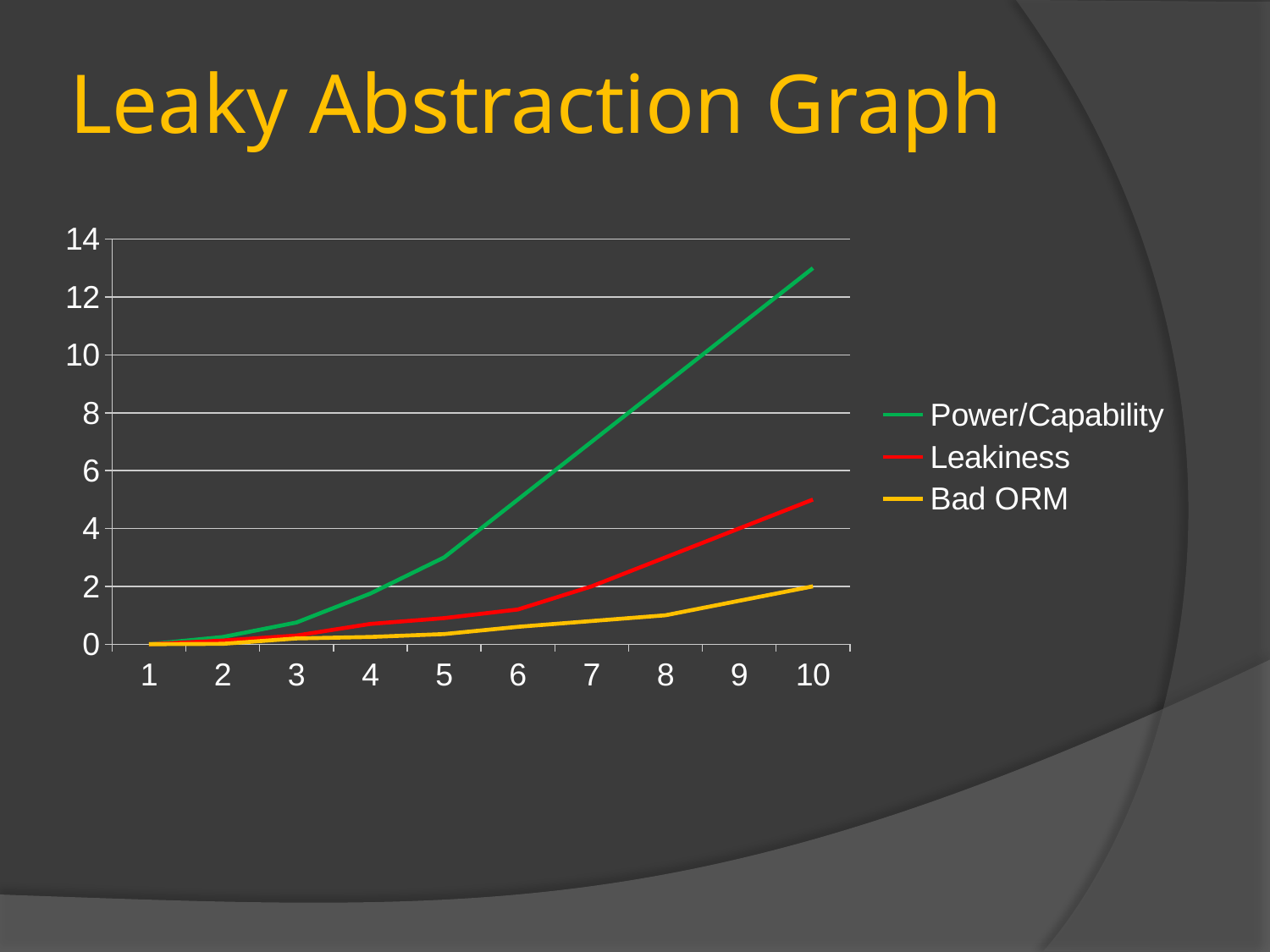
Which series has the highest value at x = 10? Power/Capability How many points are on the x axis of the chart? 10 What is the title of the slide containing the chart? Leaky Abstraction Graph Does the Power/Capability line rise or fall from x = 1 to x = 10? rise Which series has the lowest value at x = 10? Bad ORM Which series is drawn in green? Power/Capability At x = 8, which is larger: Leakiness or Bad ORM? Leakiness Is the value of Power/Capability at x = 7 greater or less than 6? greater Is the value of Power/Capability at x = 10 greater or less than 12? greater What kind of chart is shown on the slide? line chart Is the value of Leakiness at x = 10 greater or less than 6? less How many series does the legend list? 3